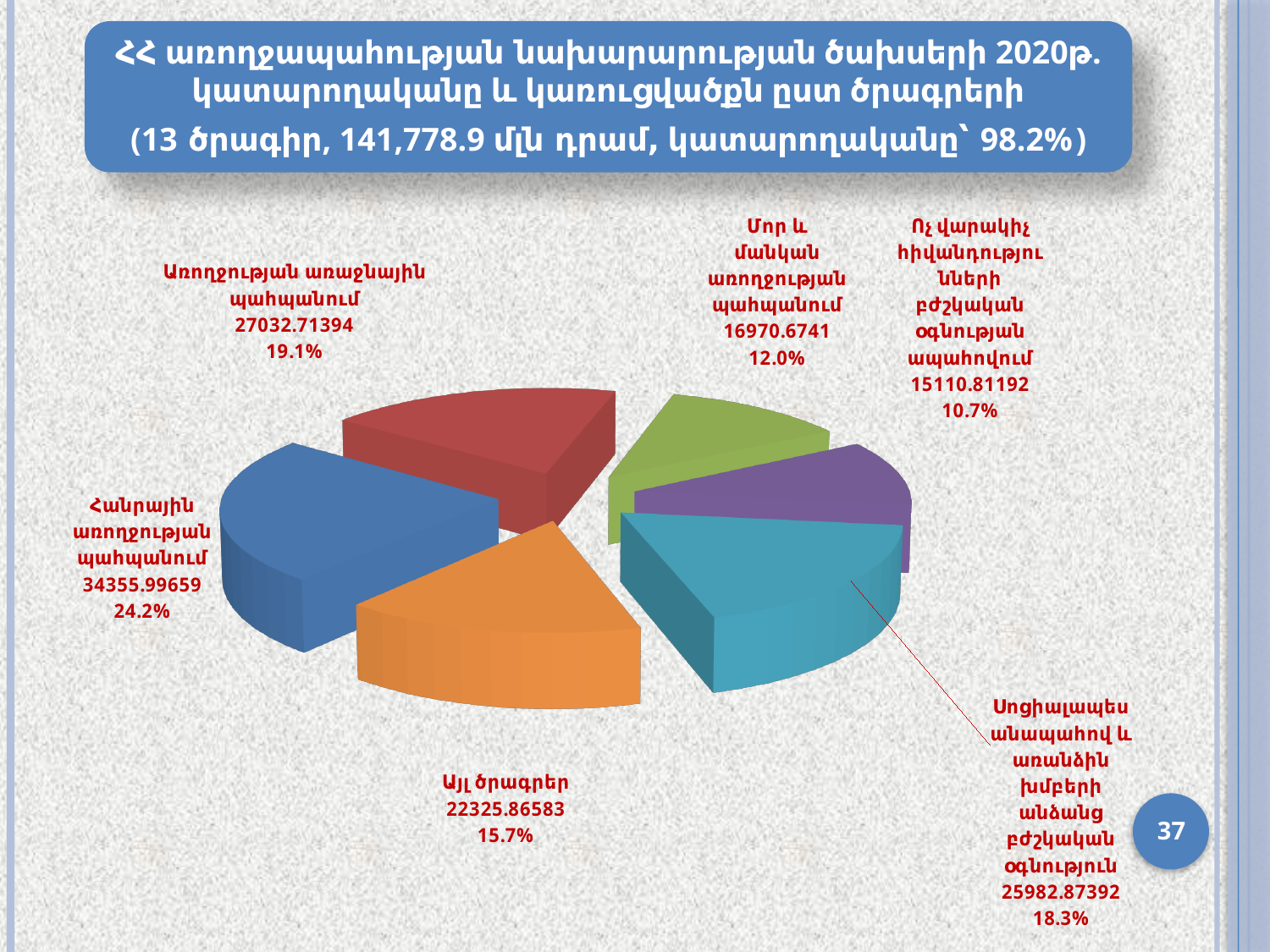
How many slices does the pie chart have? 6 What value is shown for the slice Սոցիալապես անապահով և առանձին խմբերի անձանց բժշկական օգնություն? 25982.87392 What value is shown for the slice labelled Այլ ծրագրեր? 22325.86583 What kind of chart is shown on the slide? Pie chart Which slice of the pie chart is the largest? Հանրային առողջության պահպանում What value is shown for the slice labelled Հանրային առողջության պահպանում? 34355.99659 According to the slide title, how many programs (ծրագիր) are covered and what is the total amount in million drams? 13 ծրագիր, 141,778.9 մլն դրամ What share of the pie does the slice Առողջության առաջնային պահպանում represent? 19.1% Which slice of the pie chart is the smallest? Ոչ վարակիչ հիվանդությունների բժշկական օգնության ապահովում Which slice is larger: Այլ ծրագրեր or Մոր և մանկան առողջության պահպանում? Այլ ծրագրեր What percentage is shown for the slice Մոր և մանկան առողջության պահպանում? 12.0% What is the difference between the values for Հանրային առողջության պահպանում and Առողջության առաջնային պահպանում? 7323.28265